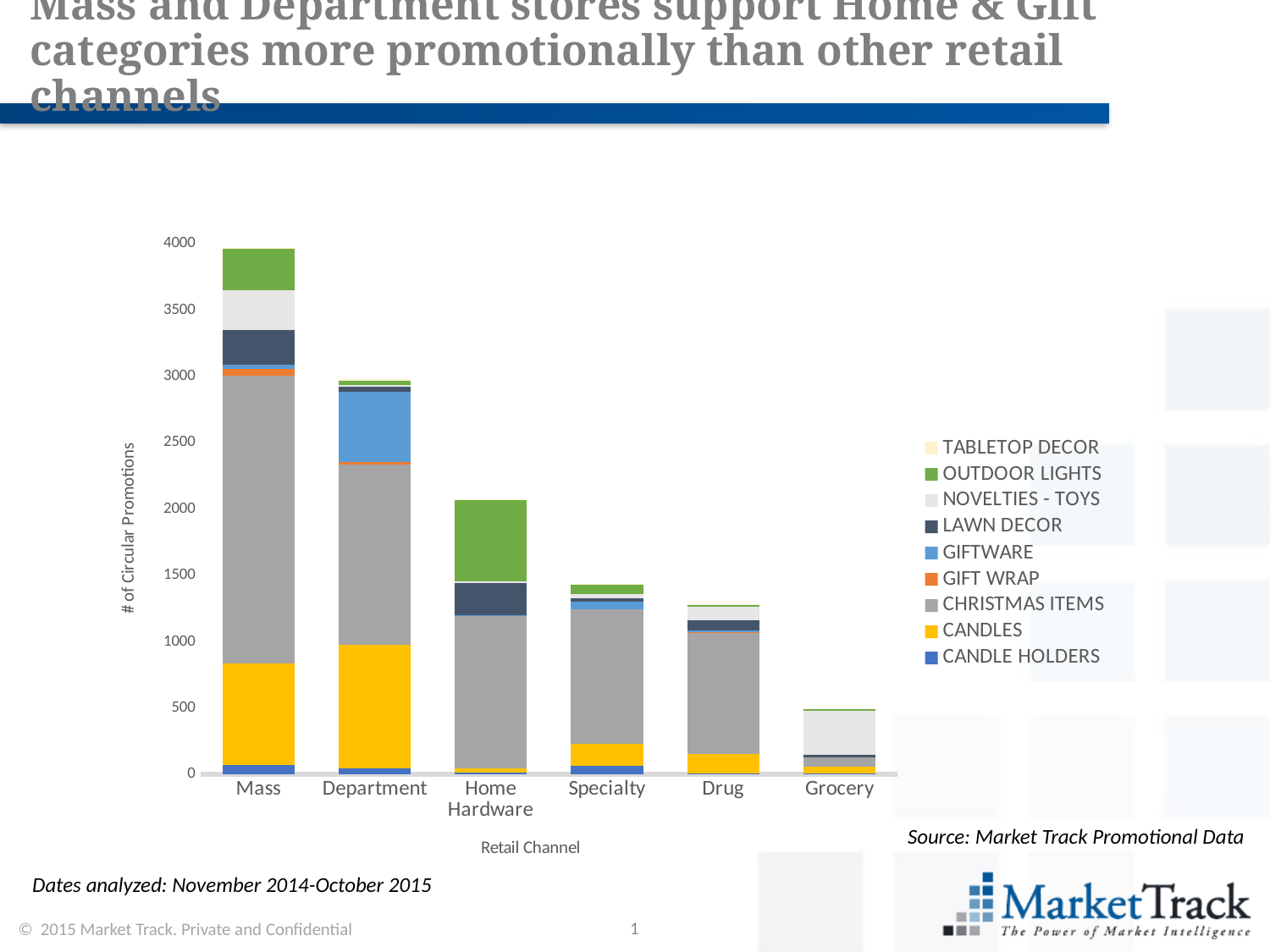
Is the total value for Department greater or less than 2500? greater Which retail channel has the highest total number of circular promotions? Mass Is the total value for Specialty greater or less than 1500? less How many retail channels are shown on the x axis? 6 Which retail channel has the lowest total number of circular promotions? Grocery How many series does the legend list? 9 What kind of chart is shown on the slide? Stacked bar chart Is the total value for Grocery greater or less than 1000? less What is the title of the y axis? # of Circular Promotions Do the total bar heights rise or fall moving from left to right along the x axis? Fall Which has a larger total number of circular promotions, Home Hardware or Specialty? Home Hardware